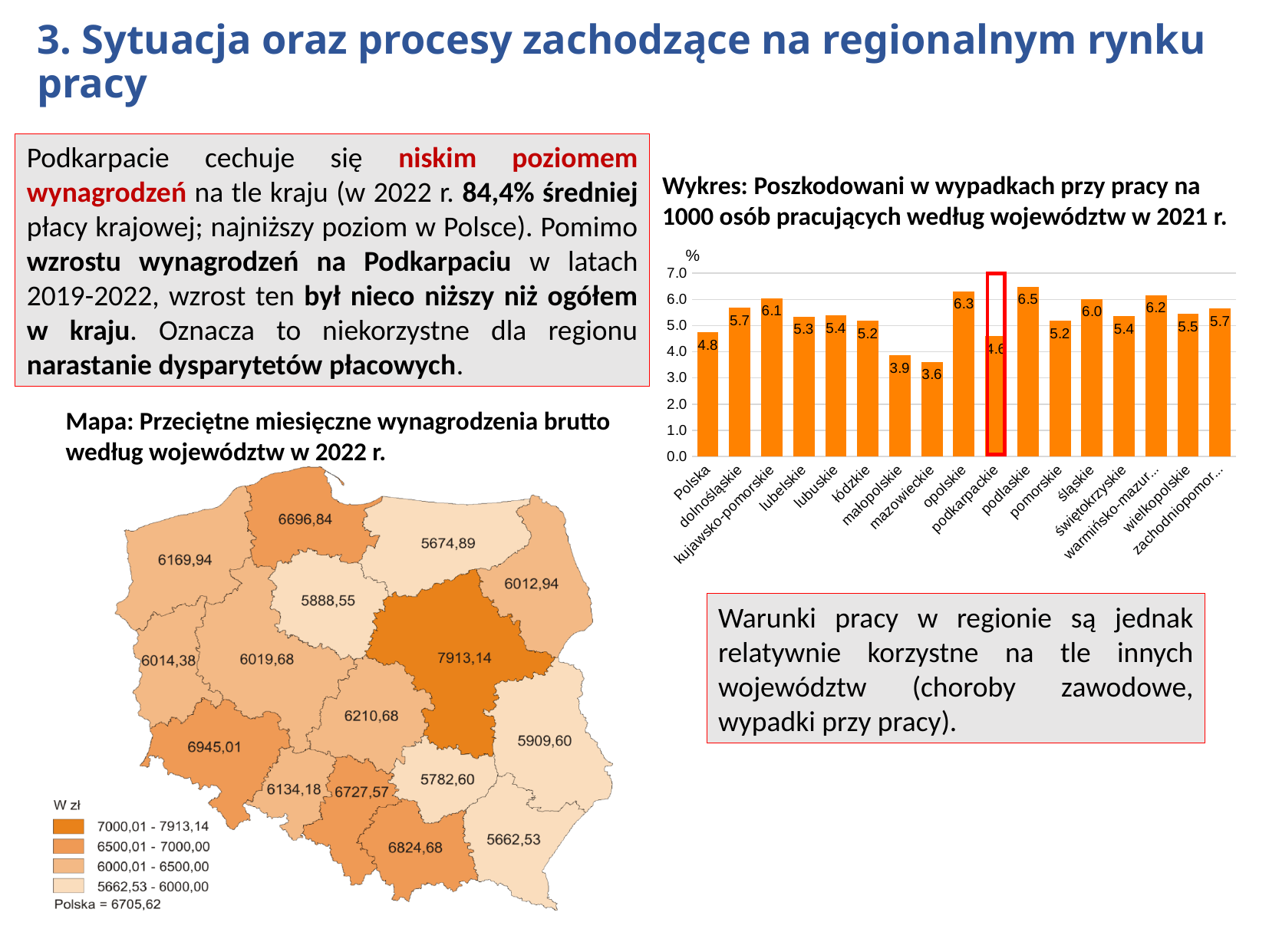
How many bars are shown in the bar chart? 17 In the bar chart, what is the difference between the values for Polska and podkarpackie? 0.2 In the bar chart, which is larger: the value for małopolskie or the value for lubelskie? lubelskie In the bar chart, which voivodeship has the highest value? podlaskie On the map, what is the highest average monthly gross wage value shown? 7913,14 In the bar chart, what is the value for Polska? 4.8 In the bar chart, what is the value for podkarpackie? 4.6 What type of chart is used to show injured persons in accidents at work by voivodeship? bar chart In the bar chart, which voivodeship has the lowest value? mazowieckie In the bar chart, what is the difference between the values for podlaskie and mazowieckie? 2.9 In the bar chart, what is the value for opolskie? 6.3 In the bar chart, is the value for śląskie greater or less than 5.0? greater